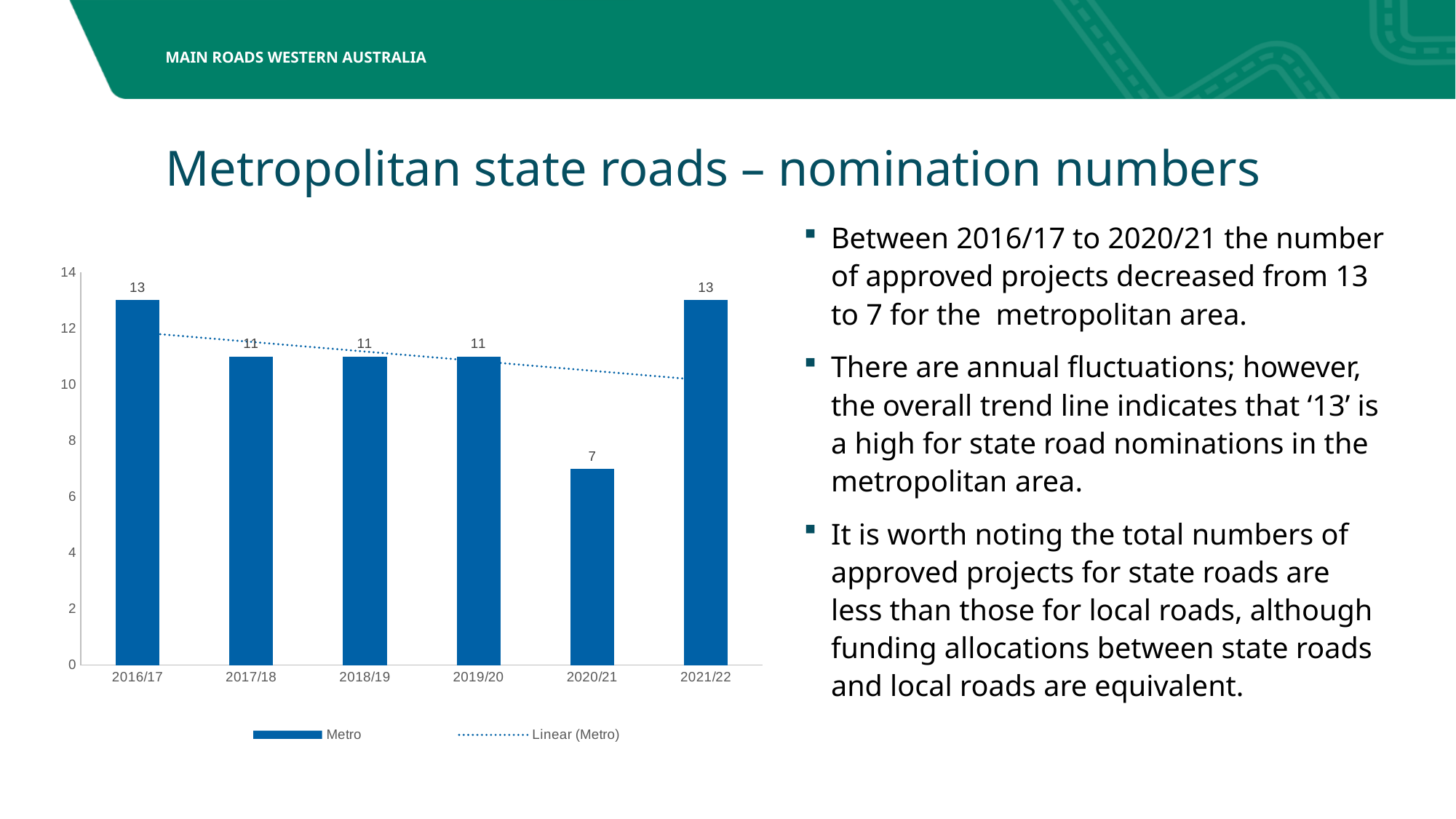
What is the Metro value for 2016/17? 13 What is the title of the slide containing the chart? Metropolitan state roads – nomination numbers Which is larger, the Metro value for 2019/20 or for 2020/21? 2019/20 What is the Metro value for 2020/21? 7 How many years are shown on the x axis? 6 Is the Metro value for 2020/21 greater or less than 8? less What kind of chart is shown on the slide? bar chart What is the Metro value for 2018/19? 11 How many entries does the legend list? 2 Which year has the lowest Metro value? 2020/21 What is the difference between the Metro values for 2016/17 and 2020/21? 6 Does the dotted Linear (Metro) trend line rise or fall from left to right? fall